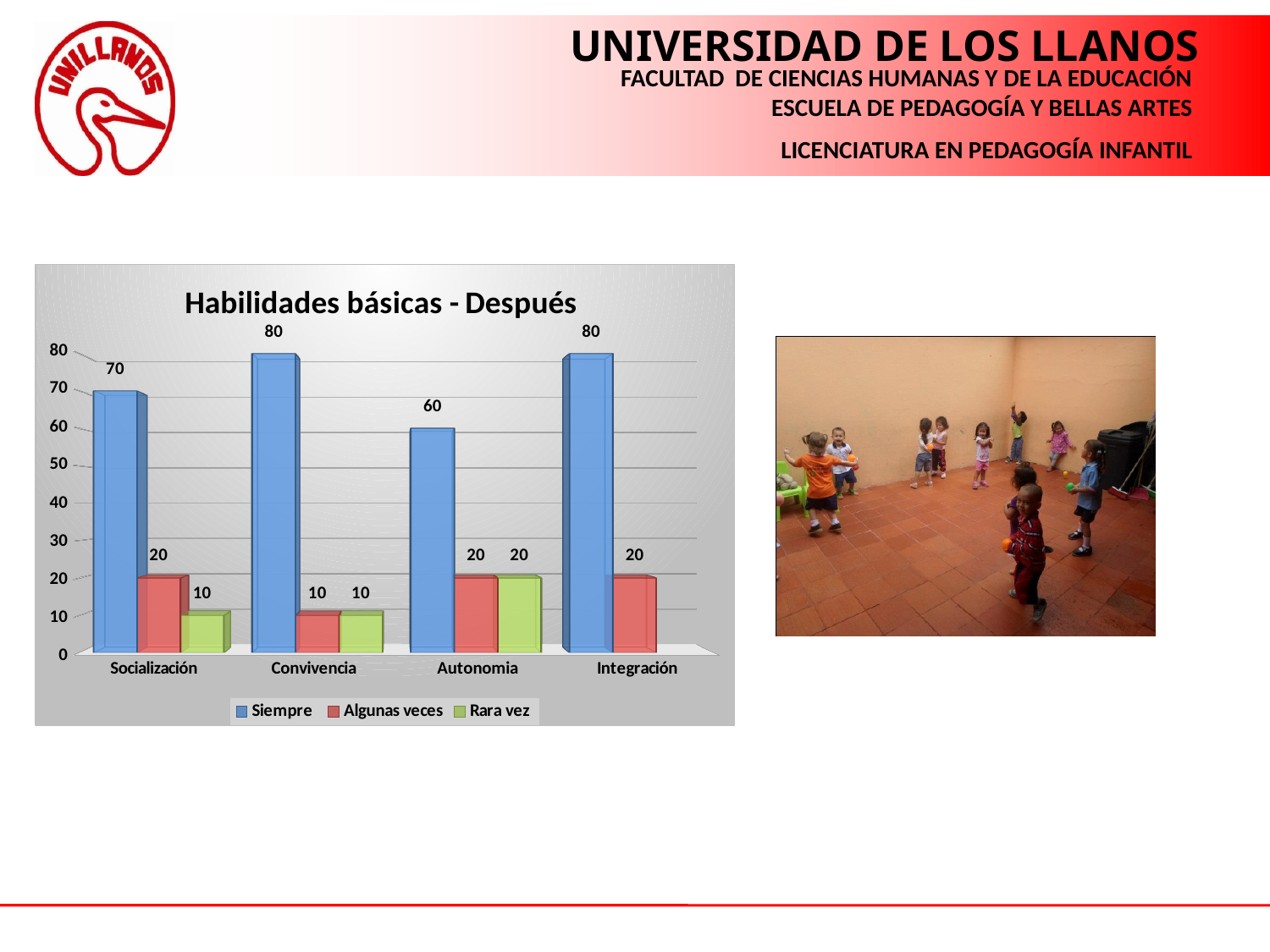
What is the value for Siempre in the Integración category? 80 What is the value for Rara vez in the Convivencia category? 10 What is the value for Algunas veces in the Autonomia category? 20 What is the title of the chart? Habilidades básicas - Después What is the value for Siempre in the Socialización category? 70 Which category has the lowest value for the Siempre series? Autonomia How many series does the legend list? 3 Which is larger: the Siempre value for Socialización or the Siempre value for Convivencia? Convivencia Which series is shown in green in the chart? Rara vez What kind of chart is shown on the slide? Bar chart How many categories are shown on the x axis of the chart? 4 What is the difference between the Siempre values for Convivencia and Autonomia? 20